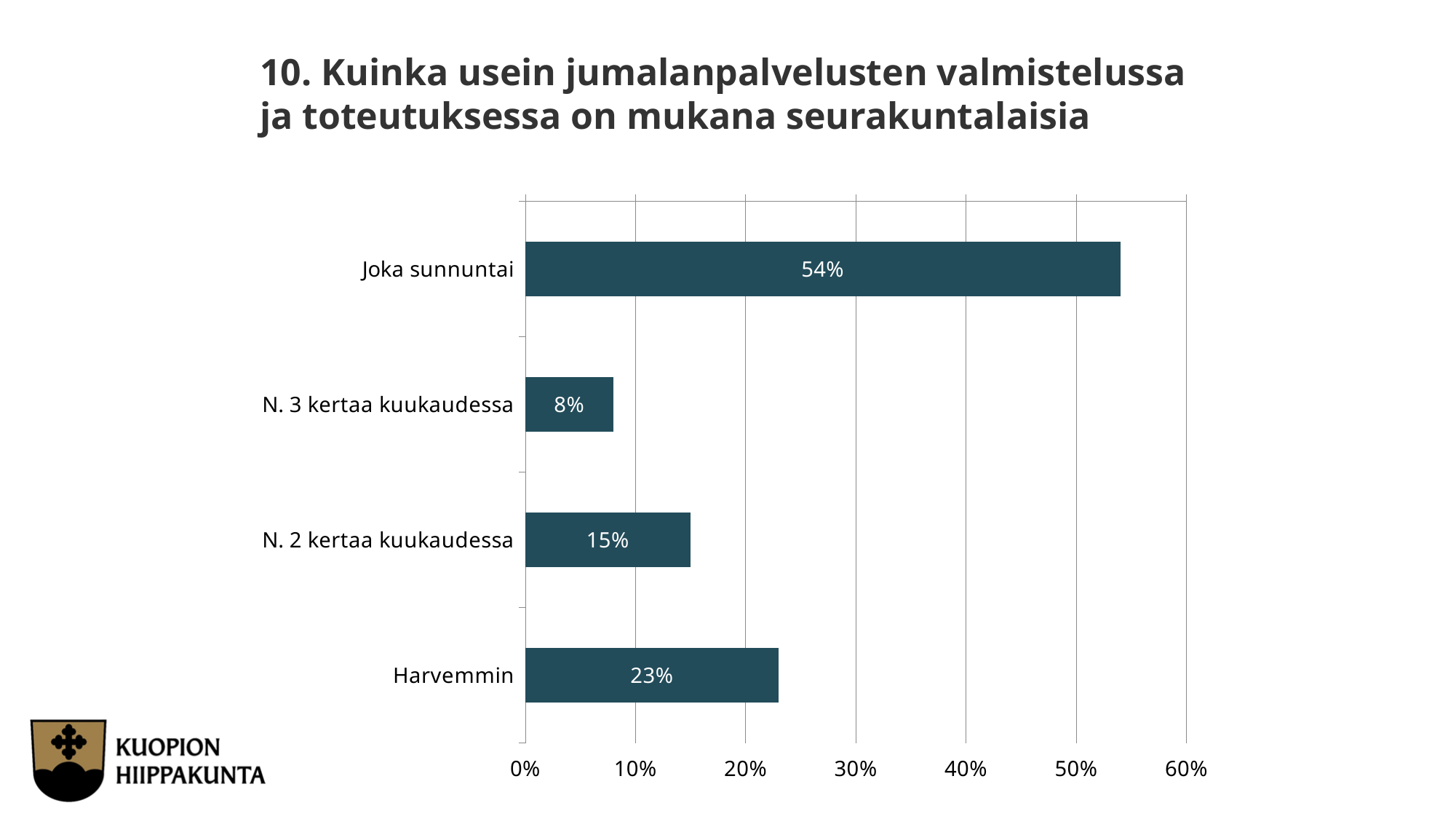
How many categories are shown in the chart? 4 Which category has the lowest value? N. 3 kertaa kuukaudessa Which is larger, the value for "Harvemmin" or the value for "N. 2 kertaa kuukaudessa"? Harvemmin What is the value for "Harvemmin"? 23% What is the value for "N. 3 kertaa kuukaudessa"? 8% Is the value for "Joka sunnuntai" greater or less than 50%? greater What is the value for "N. 2 kertaa kuukaudessa"? 15% What is the value for "Joka sunnuntai"? 54% What is the difference between the values for "N. 2 kertaa kuukaudessa" and "N. 3 kertaa kuukaudessa"? 7% What is the difference between the values for "Joka sunnuntai" and "Harvemmin"? 31% What kind of chart is shown on the slide? bar chart Which category has the highest value? Joka sunnuntai